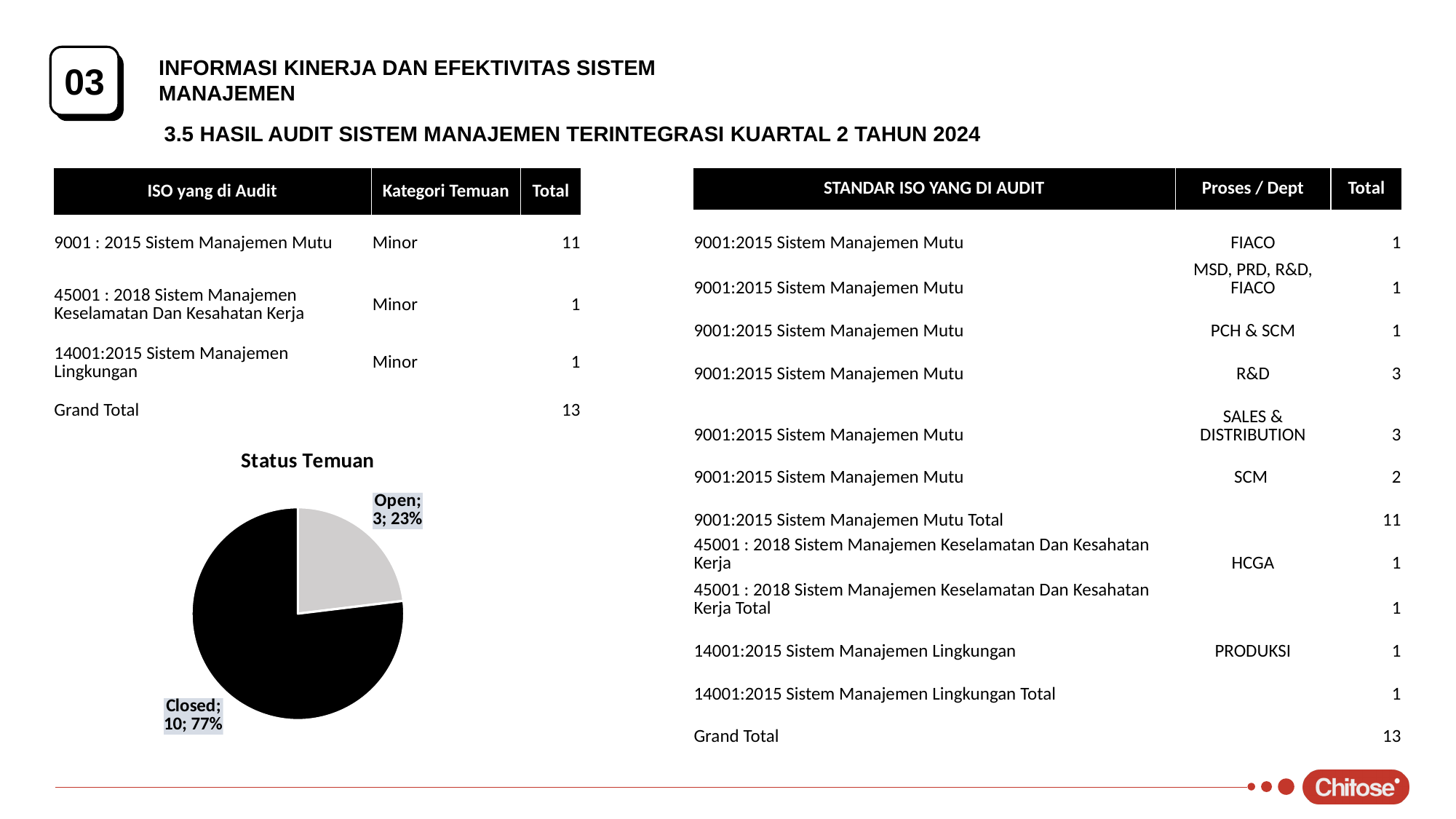
Which slice is smallest in the "Status Temuan" pie chart? Open Which slice is largest in the "Status Temuan" pie chart? Closed What share of the "Status Temuan" pie does Open represent? 23% In the "Status Temuan" pie chart, what is the difference between the Closed and Open values? 7 What is the title of the pie chart? Status Temuan What kind of chart is the "Status Temuan" chart? pie chart In the "Status Temuan" pie chart, which is larger, Open or Closed? Closed What is the value for Open in the "Status Temuan" pie chart? 3 What share of the "Status Temuan" pie does Closed represent? 77% What colour is the Closed slice in the "Status Temuan" pie chart? black What is the value for Closed in the "Status Temuan" pie chart? 10 How many slices does the "Status Temuan" pie chart have? 2